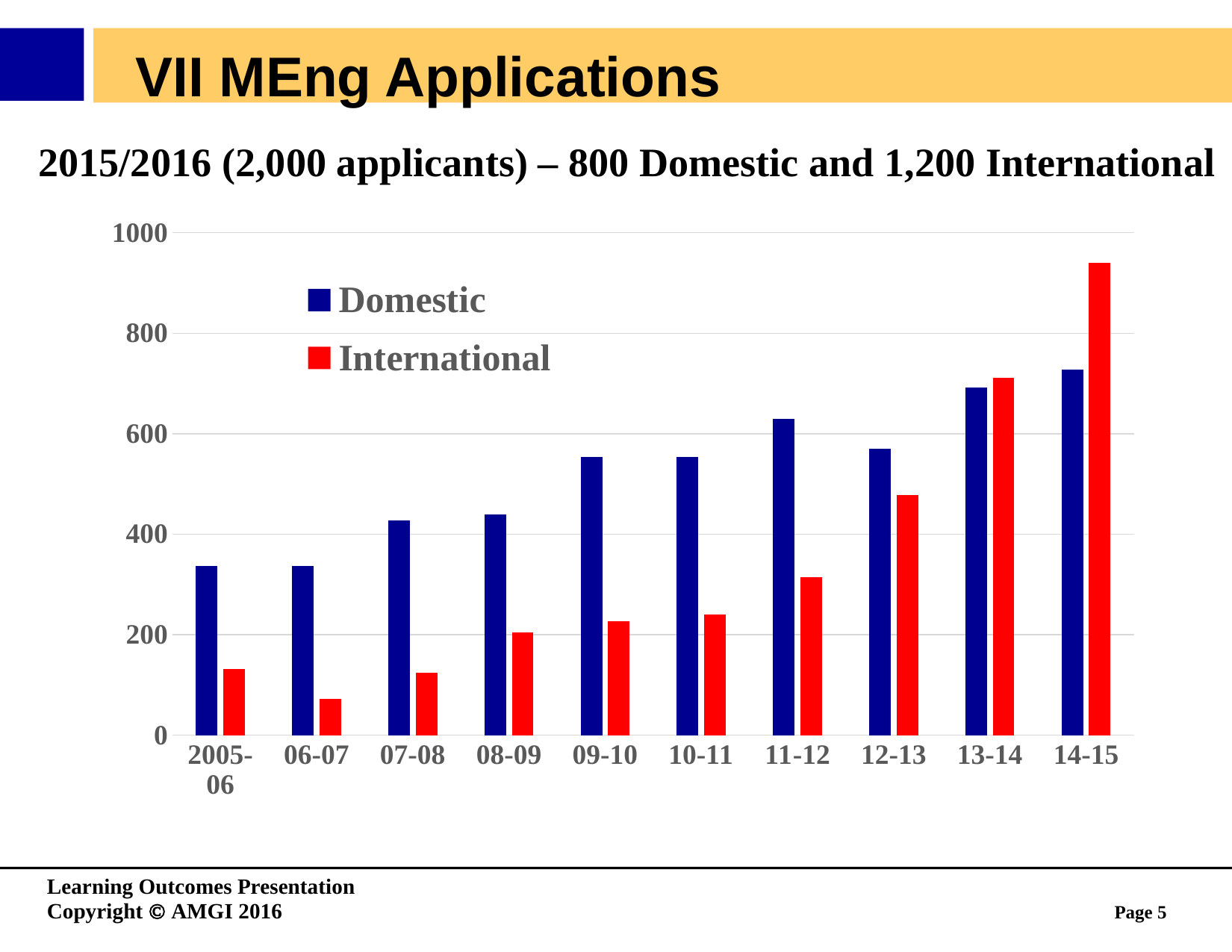
In which year is the International value highest? 14-15 Which colour represents the International series? red How many series does the legend list? 2 How many academic years are shown on the x axis? 10 Is the International value for 12-13 greater or less than 400? greater Is the Domestic value for 2005-06 greater or less than 400? less In which year is the International value lowest? 06-07 What kind of chart is shown on the slide? bar chart In which year is the Domestic value highest? 14-15 In 14-15, which is larger, the Domestic or the International value? International Is the International value for 06-07 greater or less than 100? less